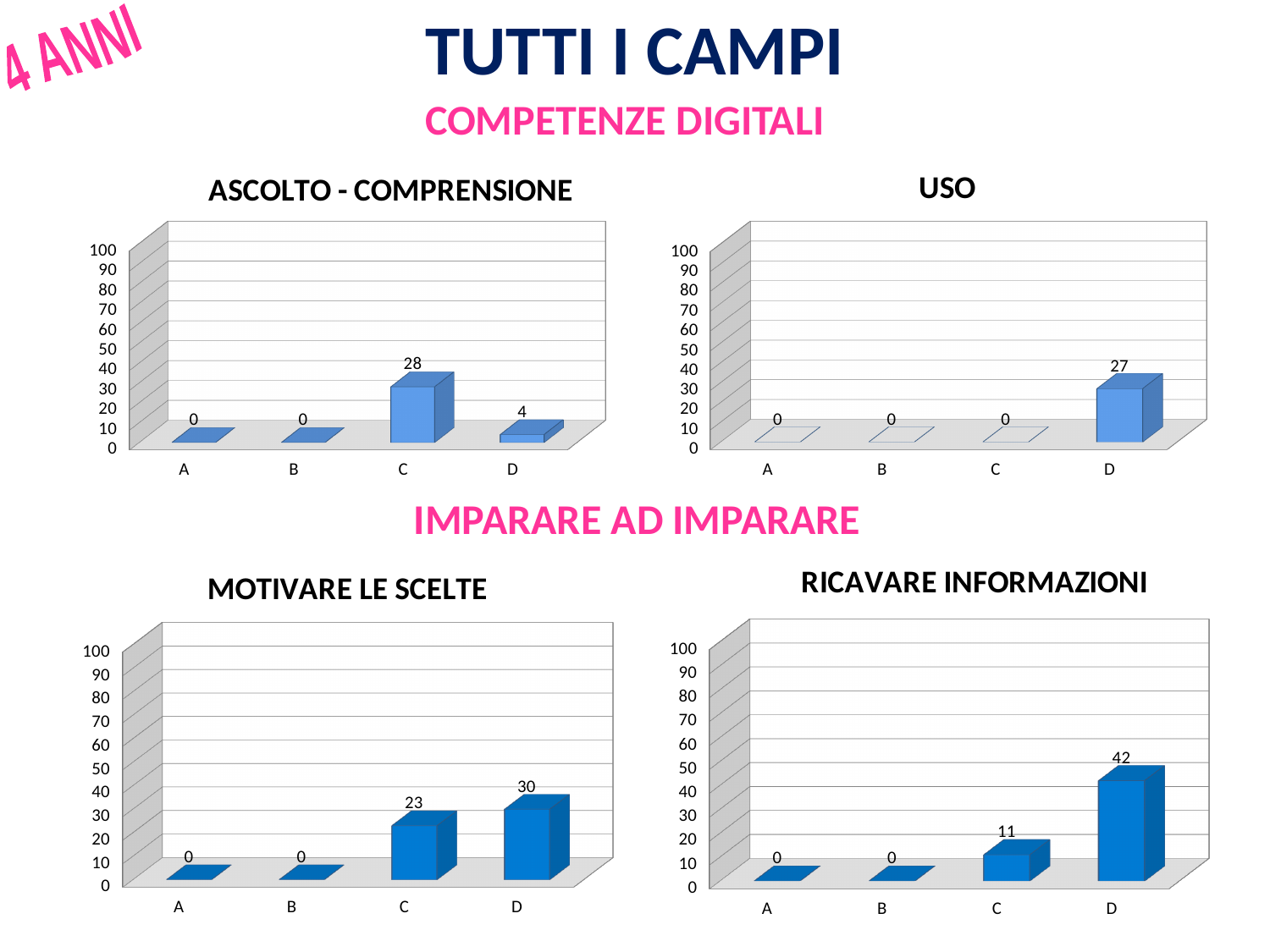
In the RICAVARE INFORMAZIONI chart, what is the value for C? 11 How many charts are shown on the slide? 4 In the ASCOLTO - COMPRENSIONE chart, what is the value for D? 4 In the RICAVARE INFORMAZIONI chart, is the value for D greater or less than 40? greater In the ASCOLTO - COMPRENSIONE chart, what is the value for C? 28 What kind of chart is the USO chart? bar chart How many categories are shown in the ASCOLTO - COMPRENSIONE chart? 4 In the USO chart, what is the value for D? 27 In the RICAVARE INFORMAZIONI chart, what is the difference between the values for D and C? 31 In the USO chart, which category has the highest value? D In the MOTIVARE LE SCELTE chart, which is larger, the value for C or the value for D? D In the MOTIVARE LE SCELTE chart, what is the difference between the values for D and C? 7